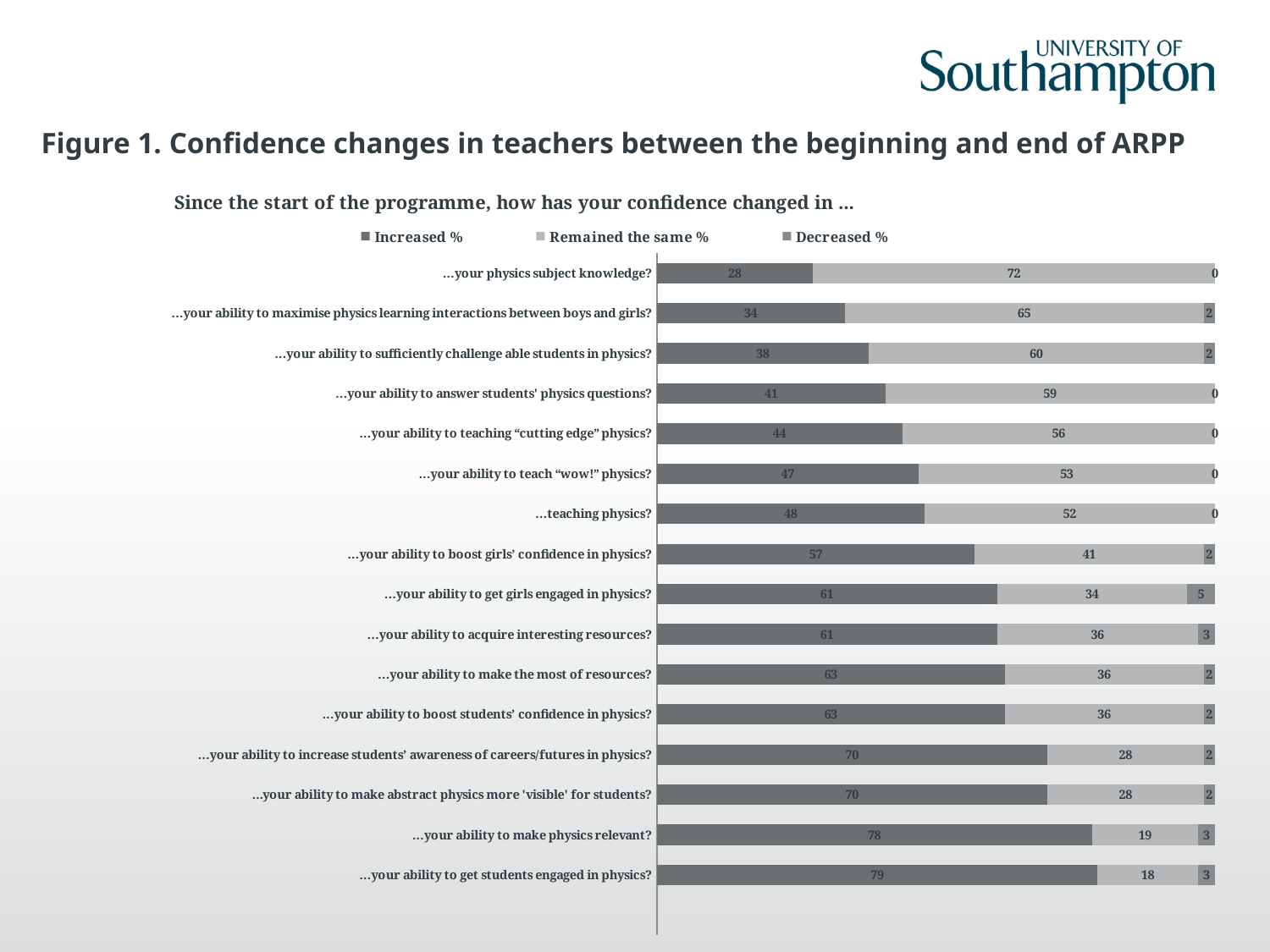
What is the Decreased % value for "...your ability to get girls engaged in physics?" 5 What is the Remained the same % value for "...your ability to make physics relevant?" 19 What is the difference between the Increased % values for "...your ability to get students engaged in physics?" and "...your physics subject knowledge?" 51 What is the total of the stacked bar for "...your ability to acquire interesting resources?" 100 Which category has the highest Increased % value? ...your ability to get students engaged in physics? What is the Increased % value for "...your physics subject knowledge?" 28 What is the title of the chart? Since the start of the programme, how has your confidence changed in ... Which category has the lowest Increased % value? ...your physics subject knowledge? What kind of chart is shown on the slide? Stacked bar chart Which has a larger Remained the same % value: "...teaching physics?" or "...your ability to boost girls' confidence in physics?" ...teaching physics? How many series does the legend list? 3 How many categories are shown on the chart? 16